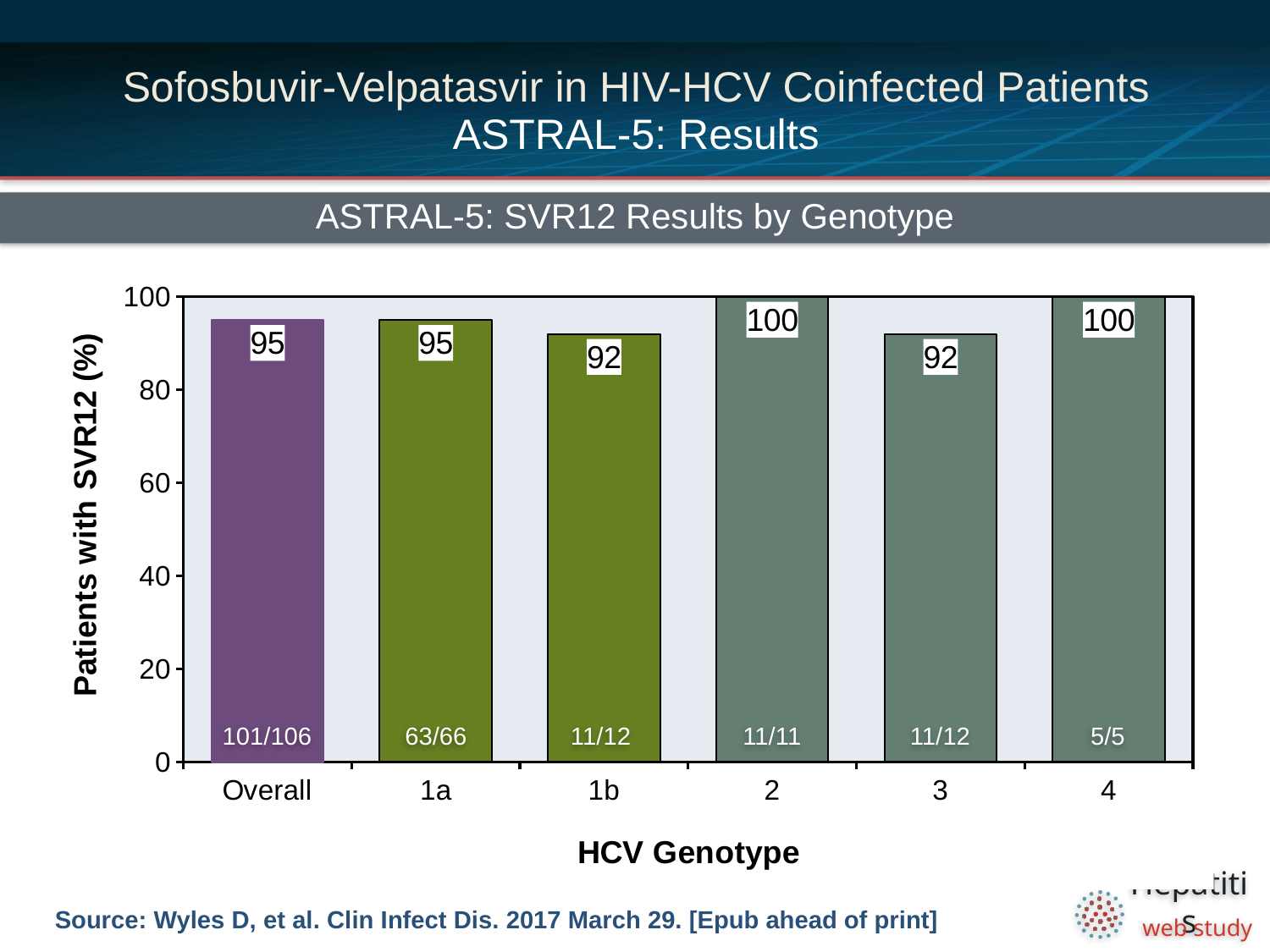
What is the label of the x axis? HCV Genotype What kind of chart is shown? bar chart What is the SVR12 rate for the Overall group? 95 What fraction of patients is shown at the base of the genotype 1a bar? 63/66 What is the SVR12 rate for genotype 1b? 92 What is the title of the chart? ASTRAL-5: SVR12 Results by Genotype How many categories are shown on the x axis? 6 Which has a higher SVR12 rate, genotype 1a or genotype 1b? 1a What is the SVR12 rate for genotype 4? 100 Which genotypes have the lowest SVR12 rate? 1b and 3 What fraction of patients is shown at the base of the Overall bar? 101/106 What is the difference in SVR12 rate between genotype 2 and genotype 3? 8